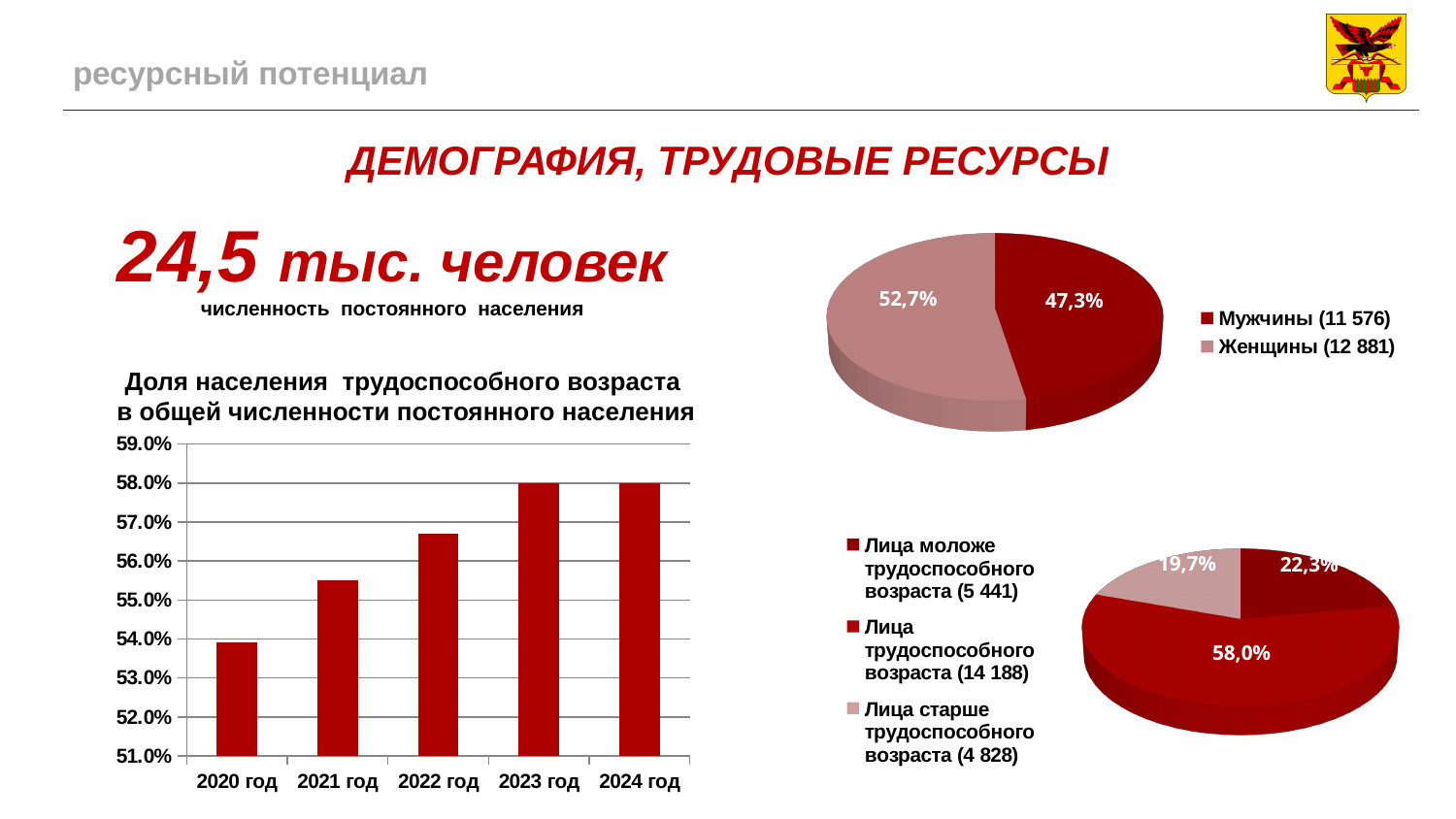
In the top-right pie chart, which slice is larger, Мужчины or Женщины? Женщины In the bar chart on the left, how many years are shown on the x axis? 5 In the bar chart on the left, is the value for 2020 год greater or less than 53.0%? greater In the top-right pie chart, what share is labelled for Женщины? 52,7% In the bottom-right pie chart, what share is labelled for Лица старше трудоспособного возраста? 19,7% In the bottom-right pie chart, which category has the largest share? Лица трудоспособного возраста (14 188) In the bar chart on the left, which year has the lowest value? 2020 год In the bar chart on the left, do the values rise or fall from 2020 год to 2024 год? rise In the top-right pie chart, what is the difference in percentage points between the Женщины and Мужчины slices? 5,4 What type of chart is the one titled 'Доля населения трудоспособного возраста в общей численности постоянного населения'? bar chart In the bar chart on the left, is the value for 2021 год greater or less than 55.0%? greater In the bar chart on the left, is the value for 2022 год greater or less than 57.0%? less